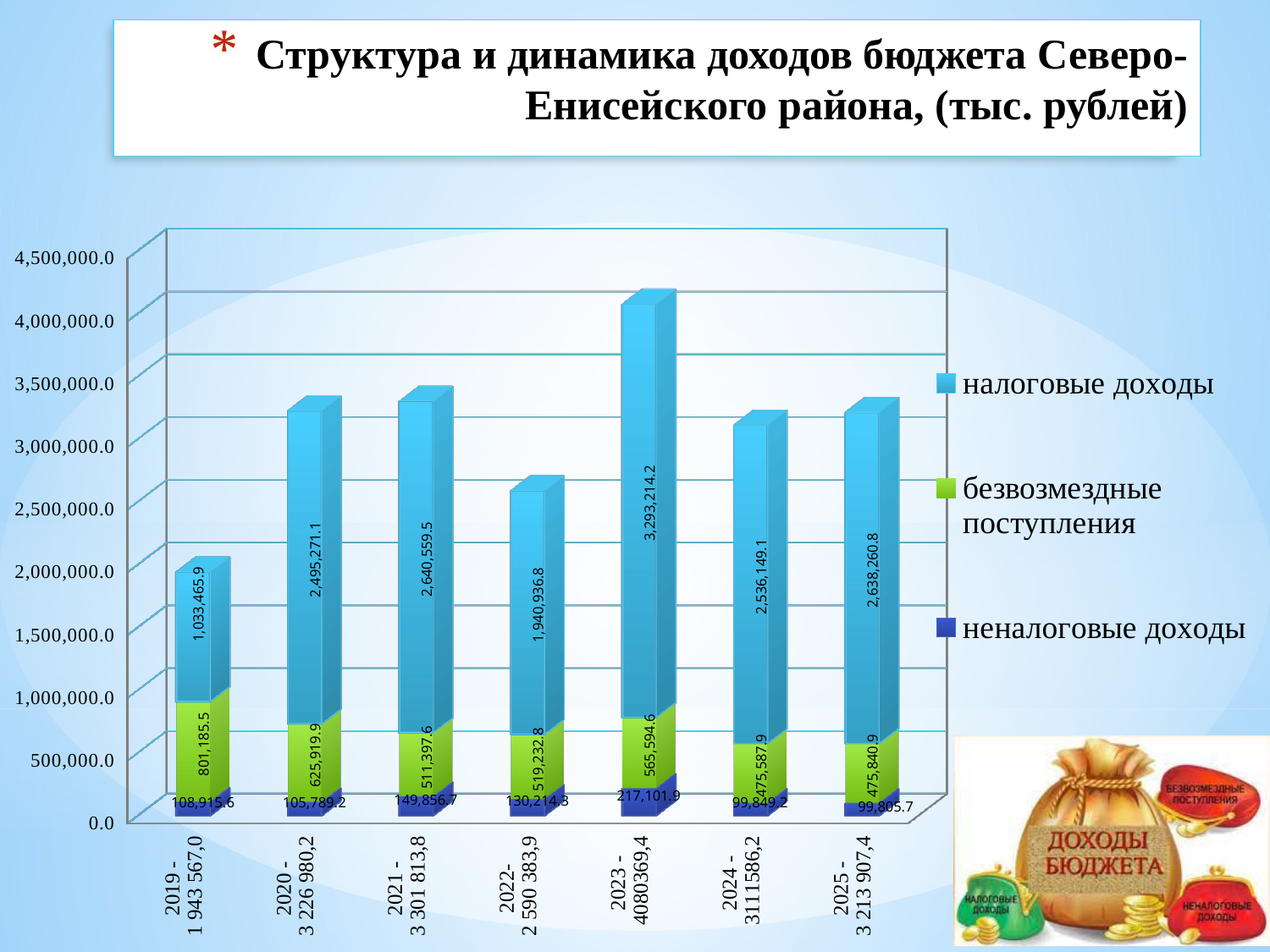
Which legend entry is shown in green? безвозмездные поступления Which year has the lowest value of налоговые доходы? 2019 Which year has the highest value of налоговые доходы? 2023 How many years (categories) are shown on the x axis? 7 What is the difference between налоговые доходы in 2025 and in 2024? 102,111.7 What is the value of неналоговые доходы for 2021? 149,856.7 What is the value of безвозмездные поступления for 2019? 801,185.5 What is the total budget income shown for 2022? 2 590 383,9 Which is larger: безвозмездные поступления in 2020 or in 2021? 2020 What type of chart is shown on the slide? stacked bar chart What is the value of налоговые доходы for 2023? 3,293,214.2 How many series does the legend list? 3